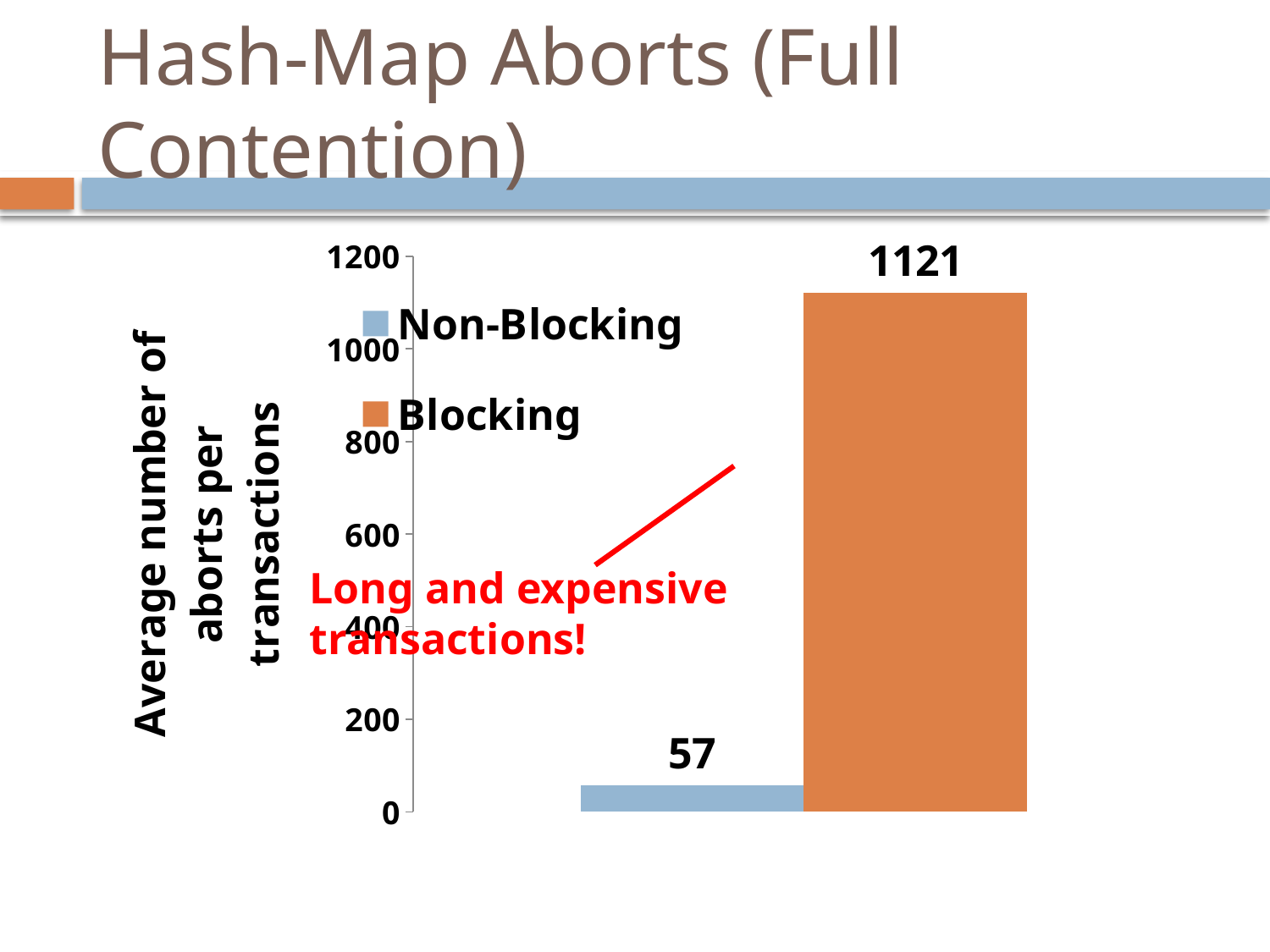
Which is larger, the value for Blocking or the value for Non-Blocking? Blocking What is the label of the vertical axis? Average number of aborts per transactions How many series does the legend list? 2 What is the difference between the Blocking and Non-Blocking values? 1064 Is the value for Blocking greater or less than 1000? greater What is the value for Blocking? 1121 What kind of chart is shown on the slide? bar chart Is the value for Non-Blocking greater or less than 200? less What colour is the Blocking bar? orange What is the value for Non-Blocking? 57 Which series has the highest value? Blocking Which series has the lowest value? Non-Blocking